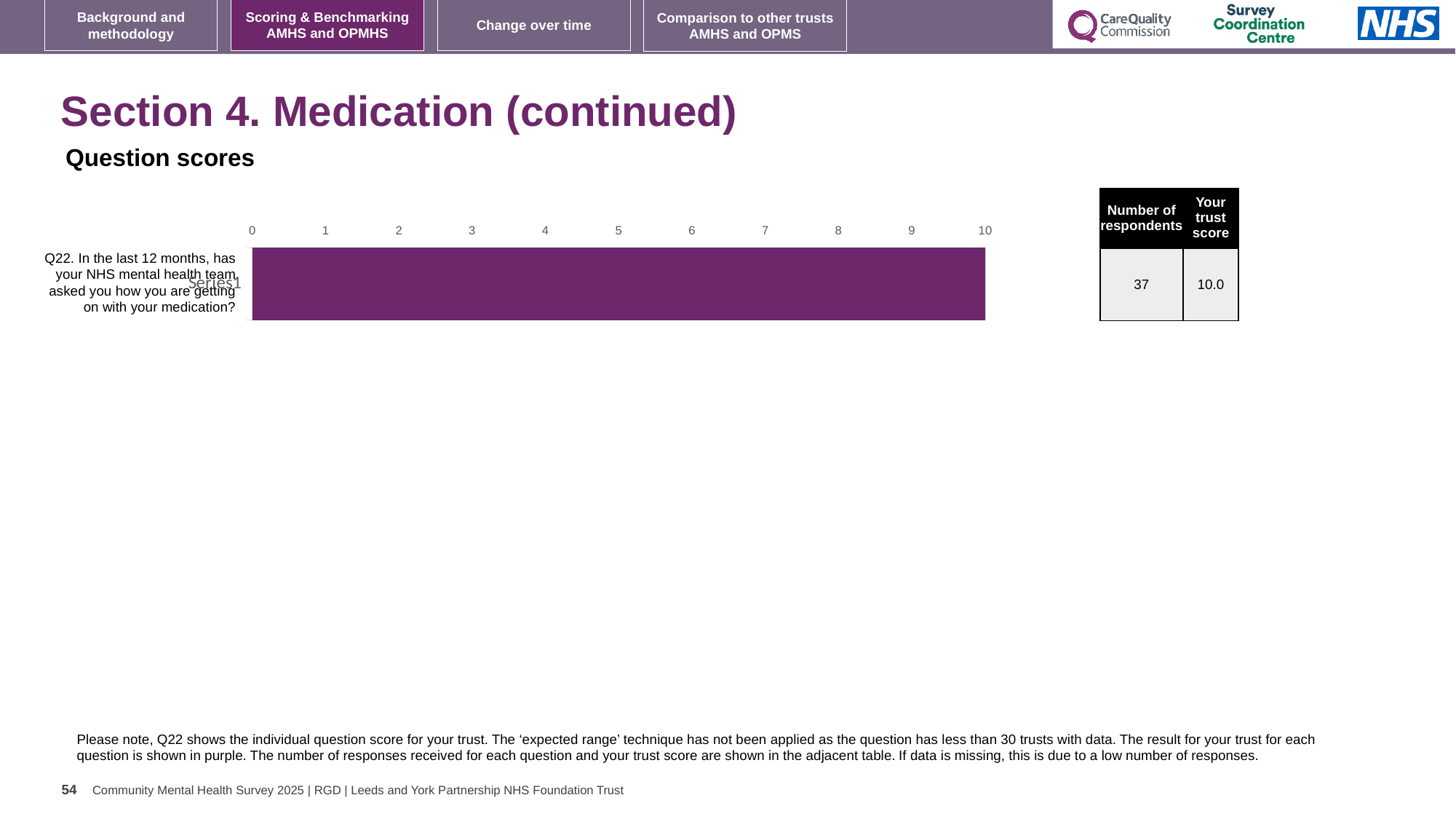
What is the trust score for Q22 shown in the chart? 10 Is the value for Q22 greater or less than 9? greater Is the value for Q22 greater or less than 5? greater According to the adjacent table, what is the trust score for Q22? 10.0 How many questions (bars) are plotted in the chart? 1 What is the maximum value shown on the chart's x axis? 10 According to the adjacent table, how many respondents answered Q22? 37 What kind of chart is shown on the slide? bar chart What colour is the bar for Q22? purple Which question is plotted in the chart? Q22. In the last 12 months, has your NHS mental health team asked you how you are getting on with your medication?